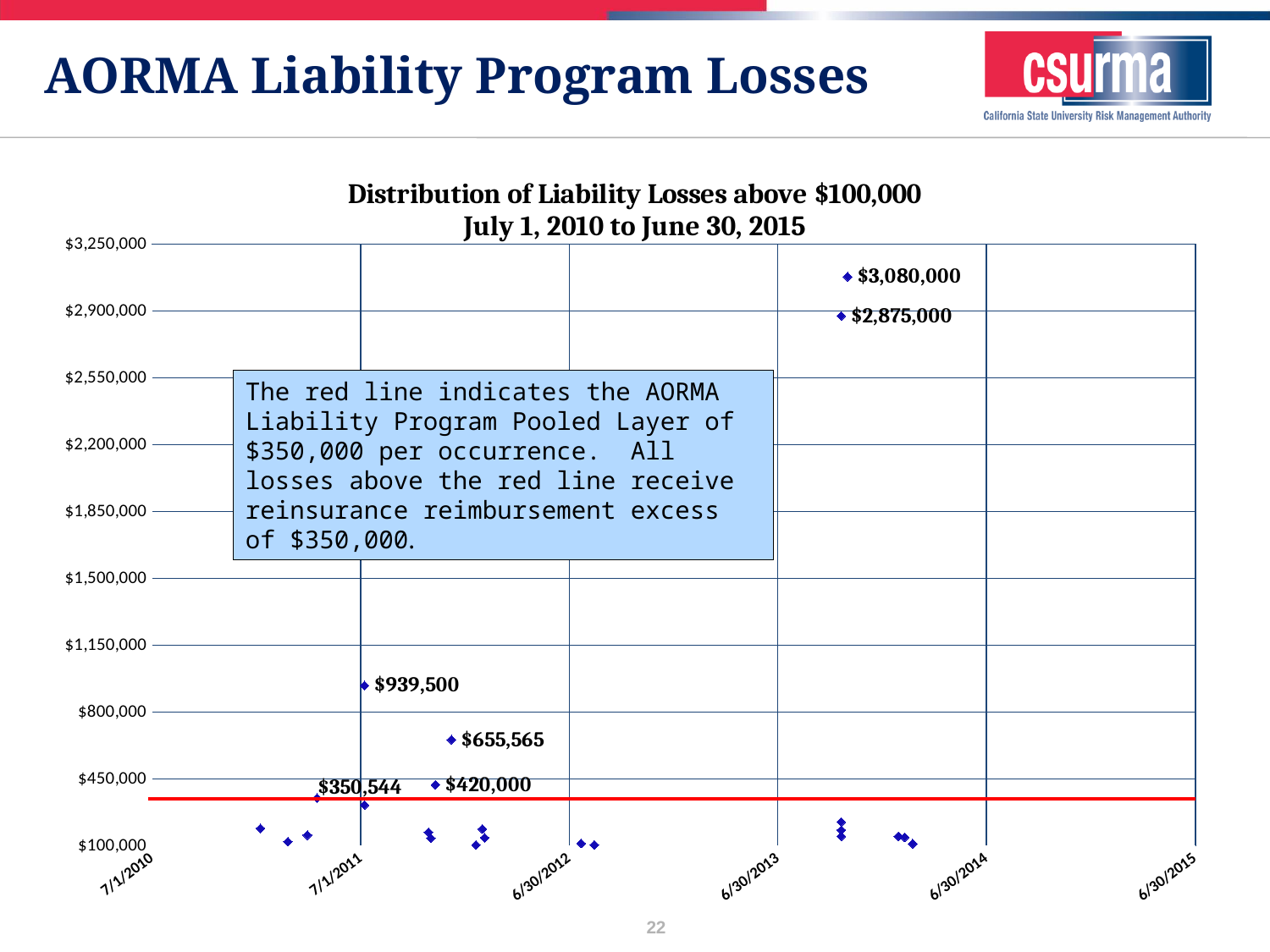
What is the title of the chart? Distribution of Liability Losses above $100,000 July 1, 2010 to June 30, 2015 What is the lowest labeled loss value on the chart? $350,544 What is the difference between the labeled losses of $939,500 and $655,565? $283,935 What is the highest labeled loss value on the chart? $3,080,000 Which labeled loss is larger, $655,565 or $420,000? $655,565 Is the labeled loss of $655,565 greater or less than $800,000 on the y axis? less Is the labeled loss of $939,500 greater or less than $800,000 on the y axis? greater What dollar amount does the red horizontal line on the chart represent? $350,000 What is the difference between the labeled losses of $420,000 and $350,544? $69,456 What kind of chart is shown on the slide? scatter chart What is the difference between the two largest labeled losses, $3,080,000 and $2,875,000? $205,000 How many date labels are shown on the x axis? 6